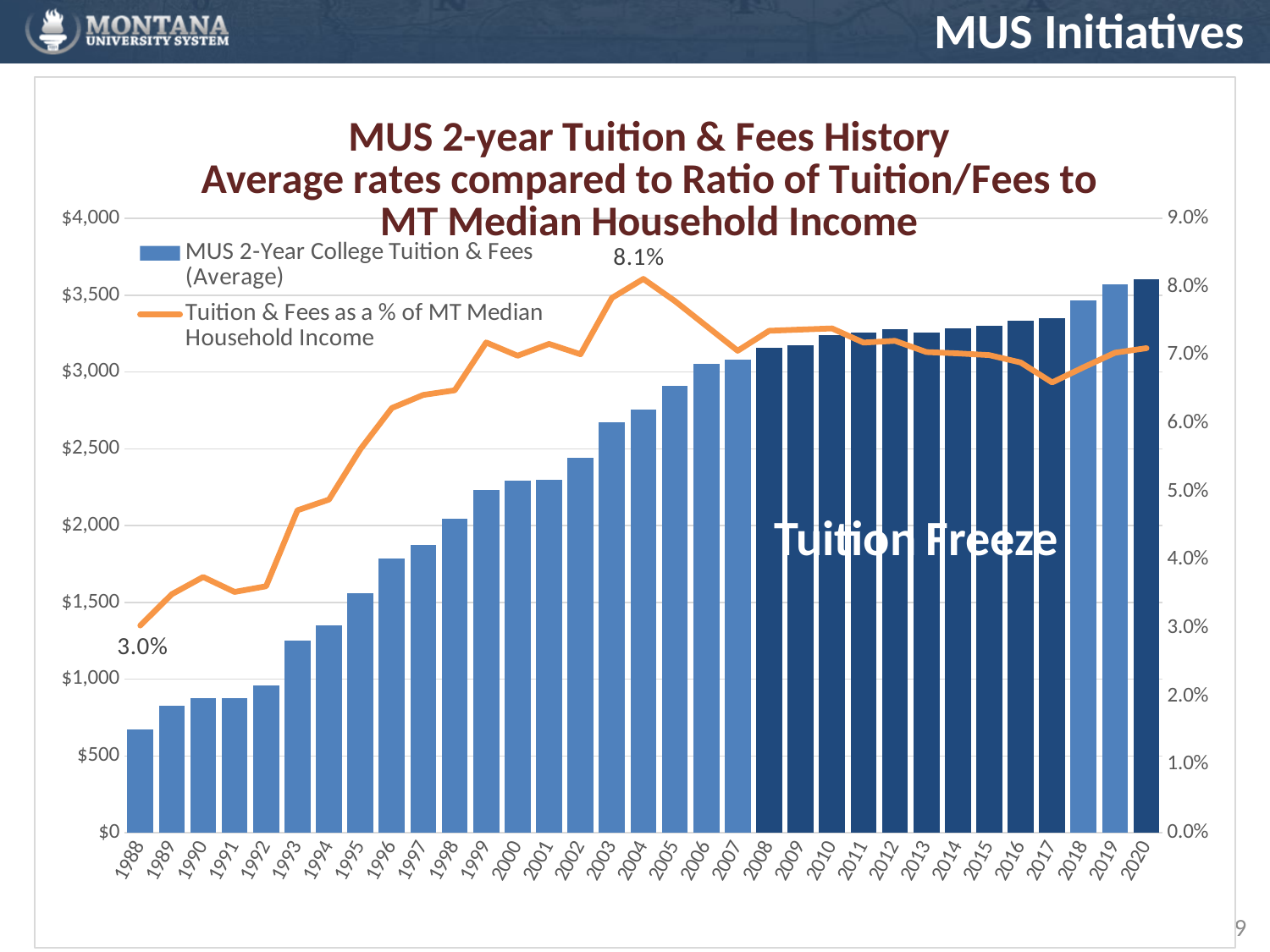
What kind of chart is shown on the slide? A bar chart combined with a line chart Do the MUS 2-Year College Tuition & Fees (Average) bars generally rise or fall from 1988 to 2020? rise In which year does the Tuition & Fees as a % of MT Median Household Income line reach its highest point? 2004 What is the difference between the 2004 and 1988 values of Tuition & Fees as a % of MT Median Household Income? 5.1 percentage points What label is written across the dark blue bars in the chart? Tuition Freeze How many years are plotted along the x axis of the chart? 33 What is the value of Tuition & Fees as a % of MT Median Household Income for 2004? 8.1% Is the MUS 2-Year College Tuition & Fees (Average) value for 2020 greater or less than $3,500? greater How many series does the chart's legend list? 2 In which year is the Tuition & Fees as a % of MT Median Household Income line at its lowest? 1988 Is the MUS 2-Year College Tuition & Fees (Average) value for 1988 greater or less than $1,000? less What is the value of Tuition & Fees as a % of MT Median Household Income for 1988? 3.0%